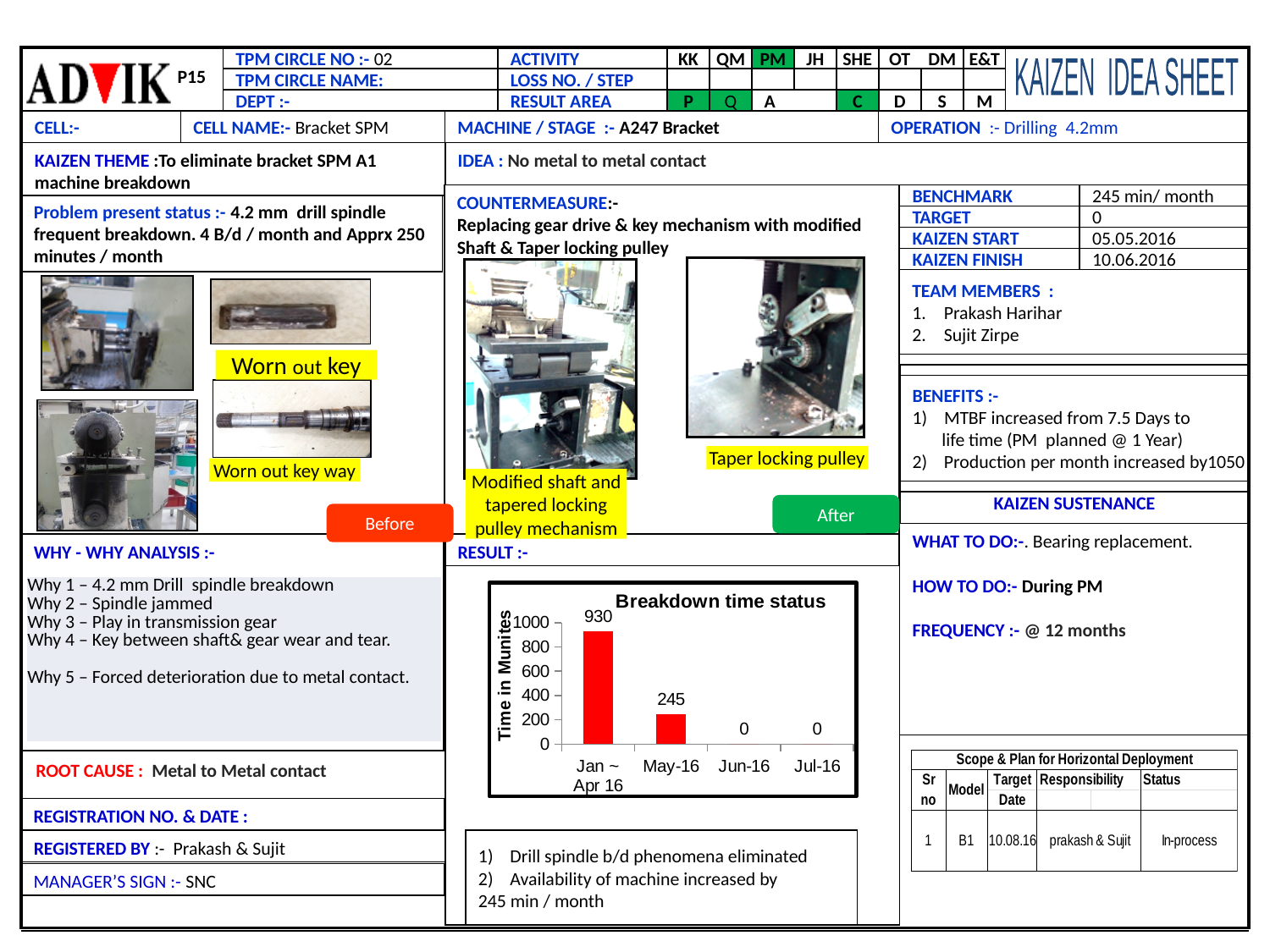
What is the breakdown time value for Jan ~ Apr 16? 930 Which has a larger breakdown time, Jan ~ Apr 16 or May-16? Jan ~ Apr 16 Do the values rise or fall from left to right along the x axis? fall What type of chart is shown on the slide? bar chart Which category has the highest breakdown time? Jan ~ Apr 16 What is the difference in breakdown time between Jan ~ Apr 16 and May-16? 685 How many categories are shown on the x axis of the chart? 4 What is the breakdown time value for Jun-16? 0 What is the title of the chart on the slide? Breakdown time status What is the breakdown time value for May-16? 245 What is the breakdown time value for Jul-16? 0 Is the value for May-16 greater or less than 400? less